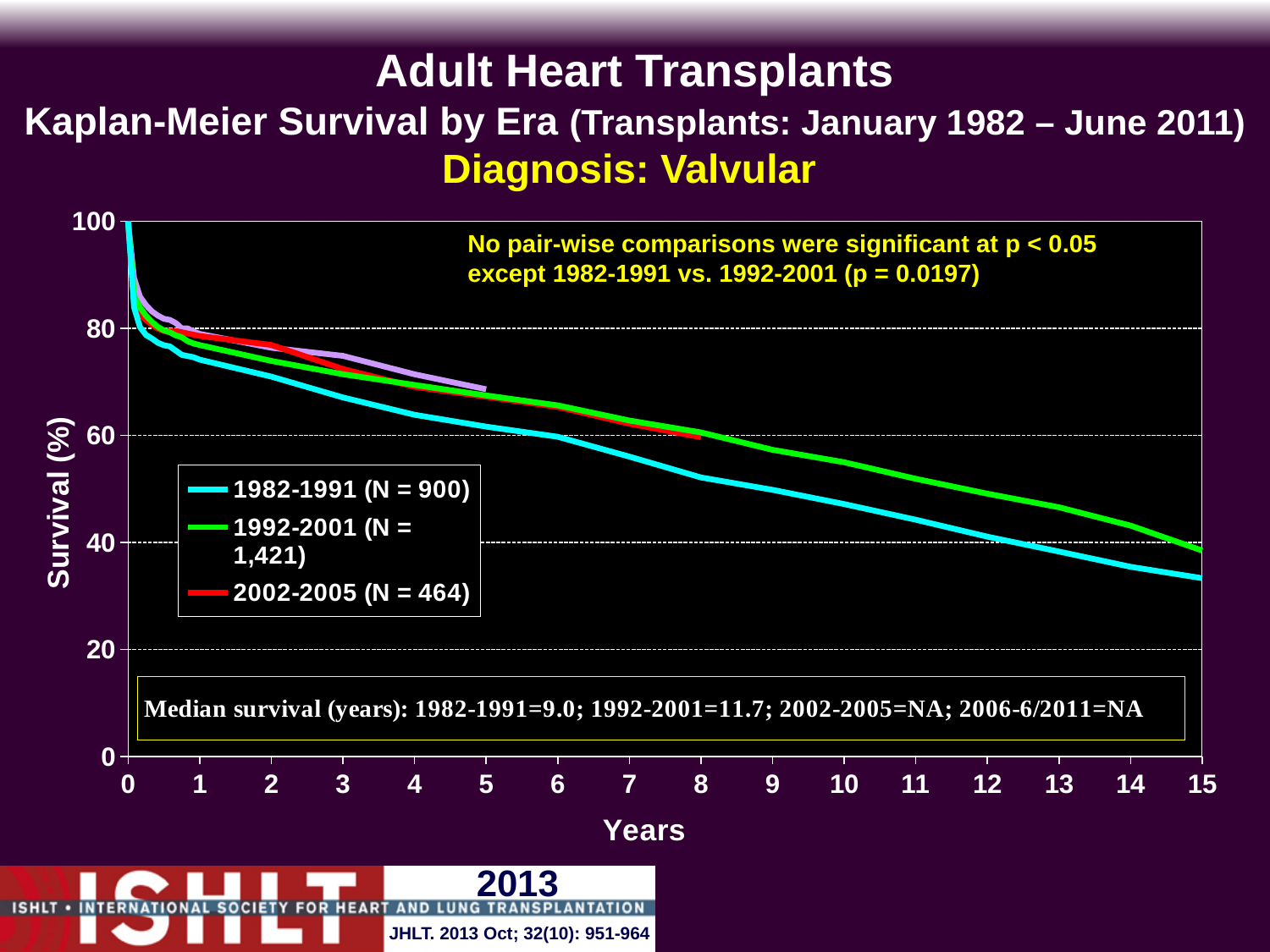
How many series does the legend list? 3 What is the N for the 1992-2001 era shown in the legend? 1,421 What is the N for the 1982-1991 era shown in the legend? 900 Is the survival for the 1982-1991 era at 15 years greater or less than 40? less What is the p-value given for the 1982-1991 vs. 1992-2001 comparison? 0.0197 What kind of chart is shown on the slide? line chart At 10 years, which era has higher survival, 1982-1991 or 1992-2001? 1992-2001 What is the N for the 2002-2005 era shown in the legend? 464 Do the survival curves rise or fall as years increase? fall Is the survival for the 1992-2001 era at 10 years greater or less than 40? greater What is the median survival in years for the 1992-2001 era? 11.7 What is the median survival in years for the 1982-1991 era? 9.0